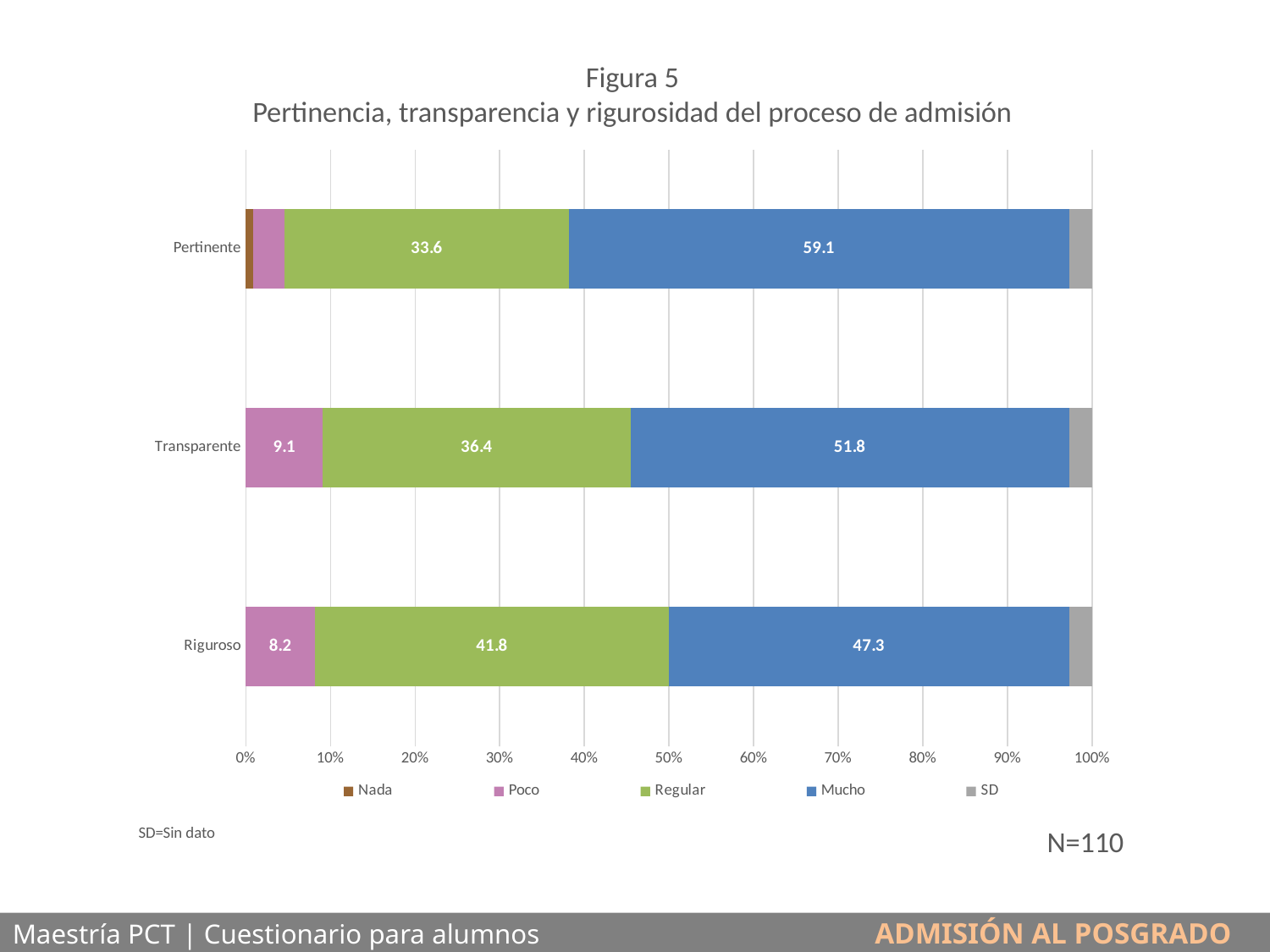
Which category has the lowest value for the Regular series? Pertinente What is the difference between the Mucho values for Pertinente and Riguroso? 11.8 What is the value of the Poco series for Transparente? 9.1 What is the value of the Regular series for Riguroso? 41.8 Which is larger, the Poco value for Transparente or the Poco value for Riguroso? Transparente How many categories are shown on the y axis? 3 What kind of chart is shown on the slide? Stacked bar chart What does SD stand for according to the note on the slide? Sin dato How many series does the legend list? 5 Which category has the highest value for the Mucho series? Pertinente Is the Mucho value for Transparente greater or less than 50? greater What is the value of the Mucho series for Pertinente? 59.1